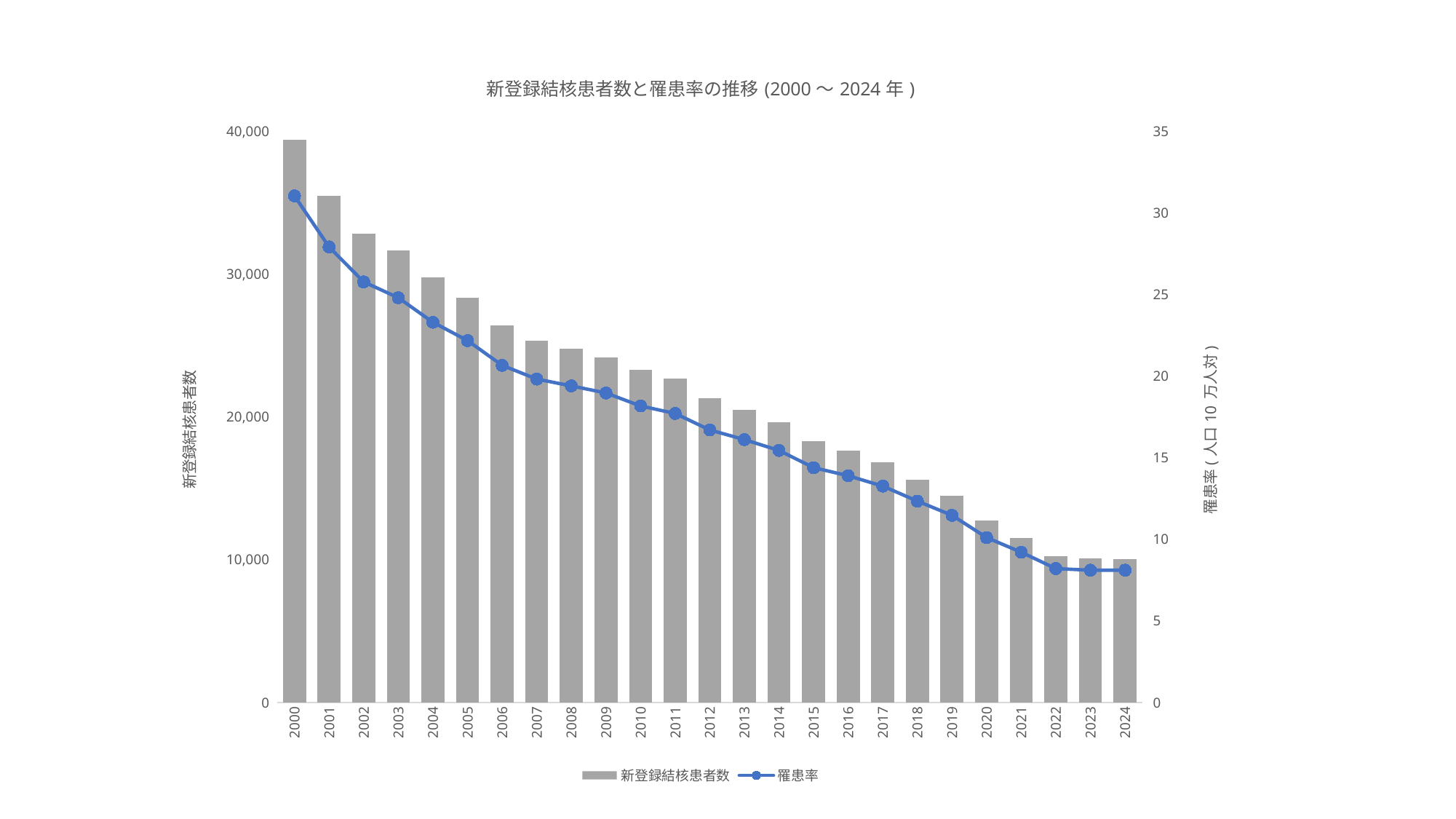
Which is larger, the 新登録結核患者数 bar for 2005 or for 2015? 2005 Which year has the highest 罹患率 value on the line? 2000 Is the 新登録結核患者数 value for 2010 greater or less than 20,000? greater How many years are plotted along the x axis? 25 How many series does the legend list? 2 Do the 罹患率 values rise or fall from 2000 to 2024? fall Which year has the highest 新登録結核患者数 bar? 2000 Is the 新登録結核患者数 value for 2020 greater or less than 15,000? less Is the 新登録結核患者数 value for 2000 greater or less than 30,000? greater What kind of chart is shown on the slide? A combined bar and line chart